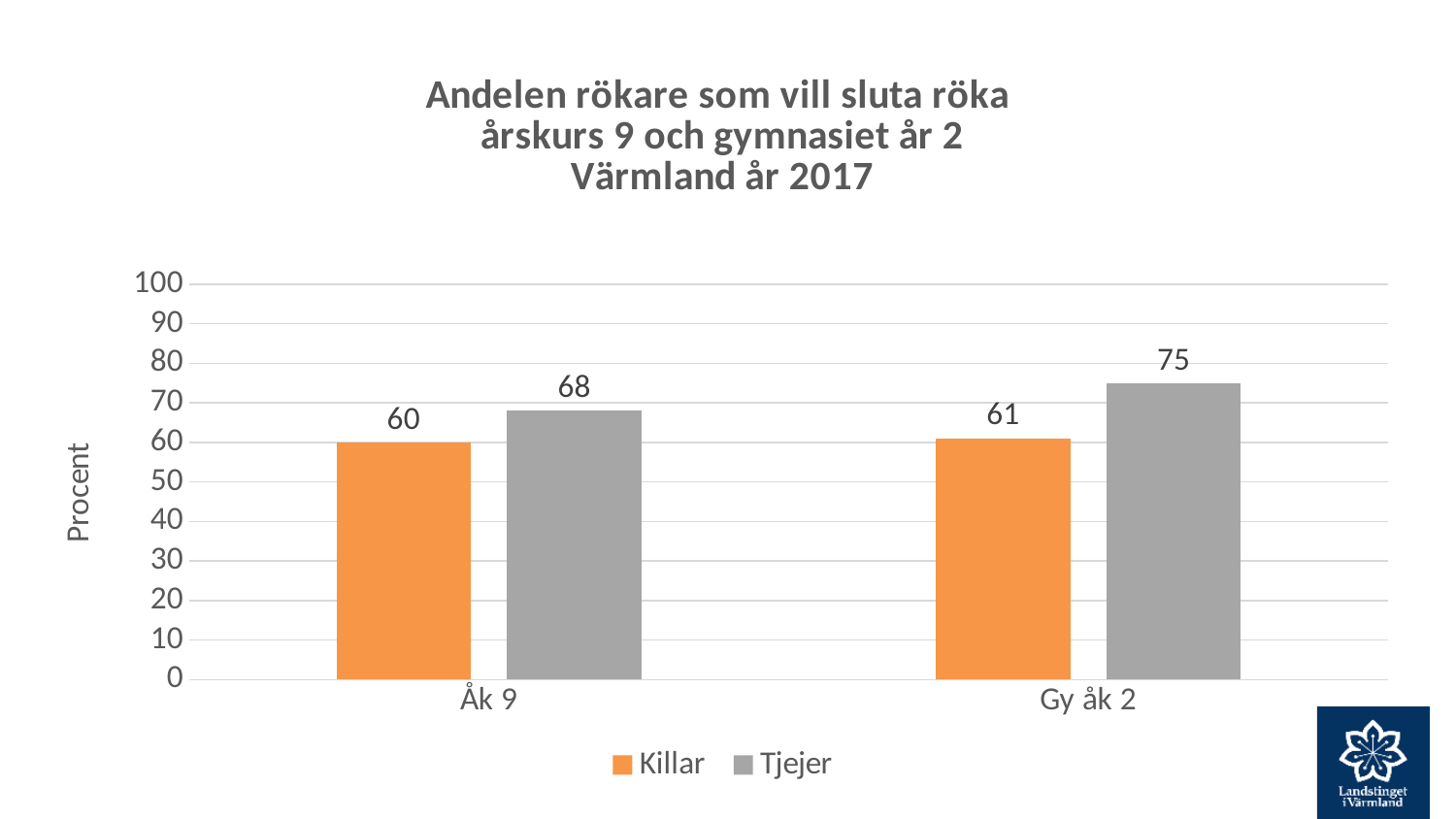
How many series does the legend list? 2 What is the value for Killar in Åk 9? 60 What is the value for Killar in Gy åk 2? 61 What is the difference between Tjejer in Gy åk 2 and Tjejer in Åk 9? 7 Which series has the highest value in Gy åk 2? Tjejer What kind of chart is shown on the slide? Bar chart What is the value for Tjejer in Gy åk 2? 75 Which is larger, Killar in Åk 9 or Tjejer in Gy åk 2? Tjejer in Gy åk 2 What is the value for Tjejer in Åk 9? 68 What is the difference between Tjejer and Killar in Åk 9? 8 Which bar has the lowest value on the chart? Killar in Åk 9 How many categories are shown on the x axis? 2